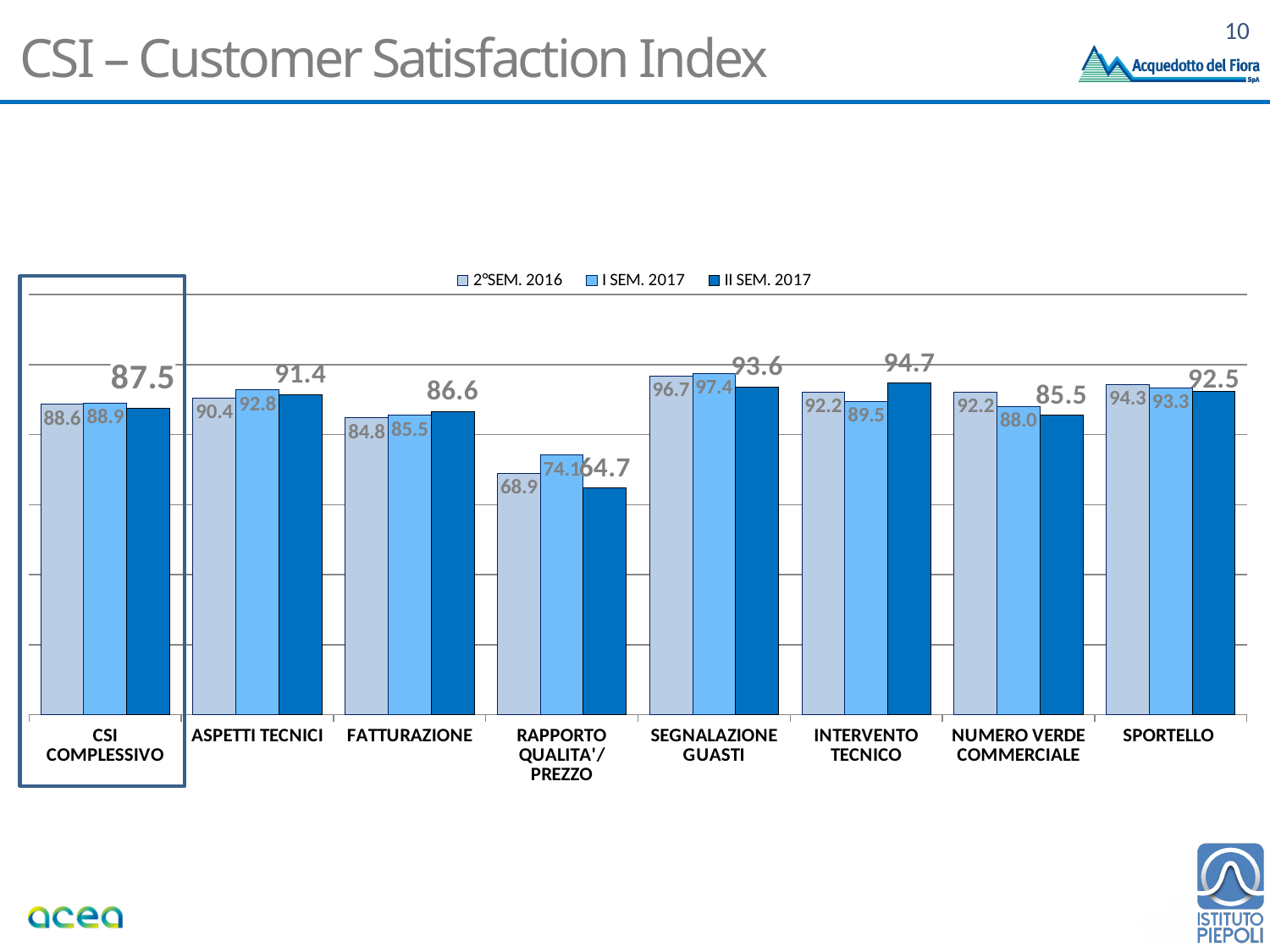
What is the difference between the I SEM. 2017 and II SEM. 2017 values for RAPPORTO QUALITA'/PREZZO? 9.4 Do the values for FATTURAZIONE rise or fall from 2°SEM. 2016 to II SEM. 2017? Rise What is the I SEM. 2017 value for SEGNALAZIONE GUASTI? 97.4 Which category has the highest II SEM. 2017 value? INTERVENTO TECNICO How many series does the legend list? 3 How many categories are shown on the x axis? 8 Which category has the lowest II SEM. 2017 value? RAPPORTO QUALITA'/PREZZO What is the 2°SEM. 2016 value for RAPPORTO QUALITA'/PREZZO? 68.9 What kind of chart is shown on the slide? Bar chart Which is larger for NUMERO VERDE COMMERCIALE: the 2°SEM. 2016 value or the II SEM. 2017 value? 2°SEM. 2016 What is the II SEM. 2017 value for INTERVENTO TECNICO? 94.7 What is the II SEM. 2017 value for CSI COMPLESSIVO? 87.5